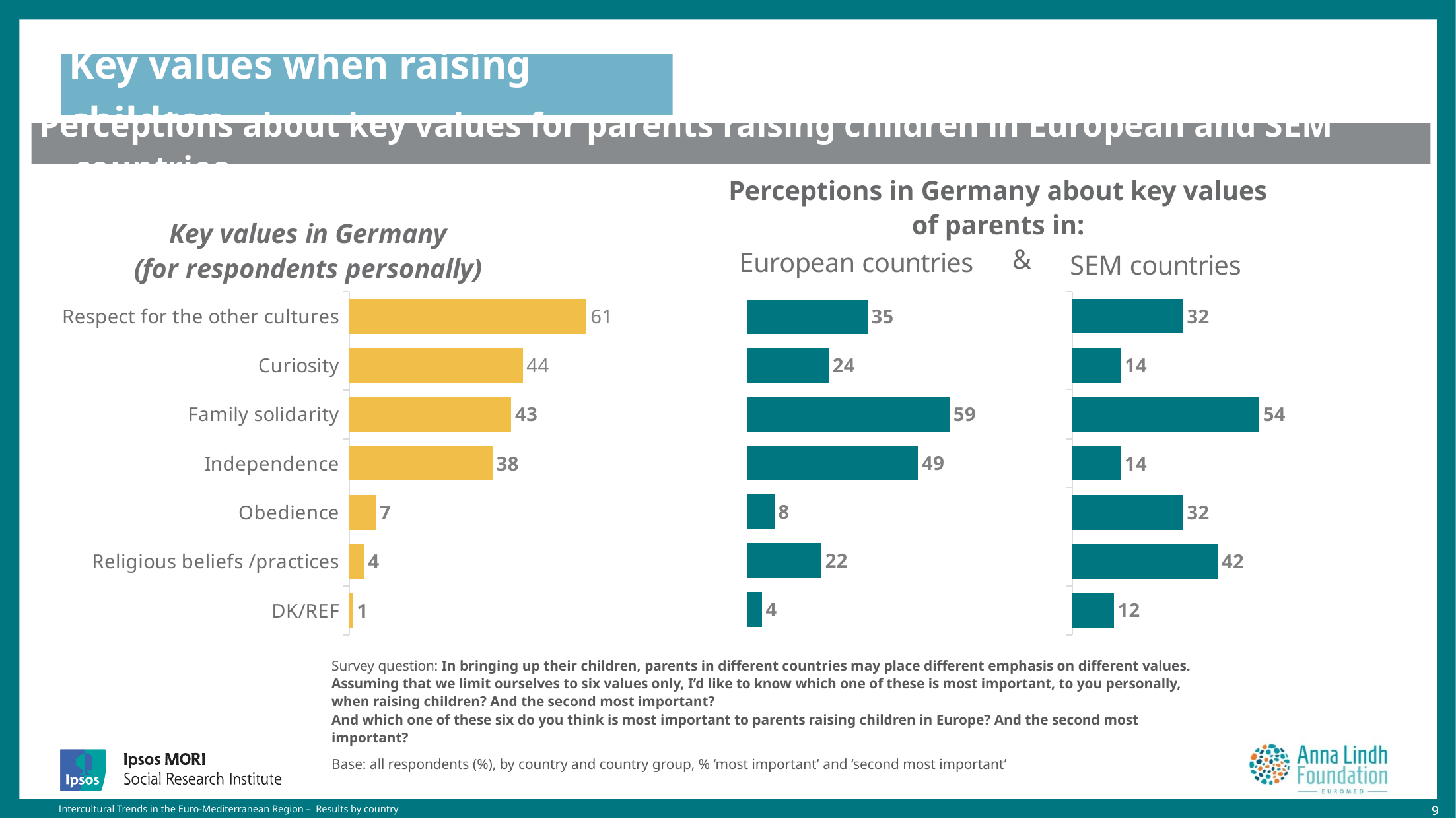
In the 'European countries' chart, what is the value for Family solidarity? 59 What is the difference between the Obedience values in the 'SEM countries' chart and the 'European countries' chart? 24 How many categories are shown in the 'Key values in Germany (for respondents personally)' chart? 7 In the 'Key values in Germany (for respondents personally)' chart, what is the value for Respect for the other cultures? 61 In the 'SEM countries' chart, what is the value for Religious beliefs /practices? 42 In the 'European countries' chart, which category has the lowest value? DK/REF In the 'SEM countries' chart, which category has the highest value? Family solidarity In the 'Key values in Germany (for respondents personally)' chart, which category has the highest value? Respect for the other cultures In the 'Key values in Germany (for respondents personally)' chart, which category has the lowest value? DK/REF Which is larger: the Independence value in the 'European countries' chart or in the 'SEM countries' chart? European countries What kind of chart is the 'Key values in Germany (for respondents personally)' chart? Bar chart What colour are the bars in the 'Key values in Germany (for respondents personally)' chart? Yellow